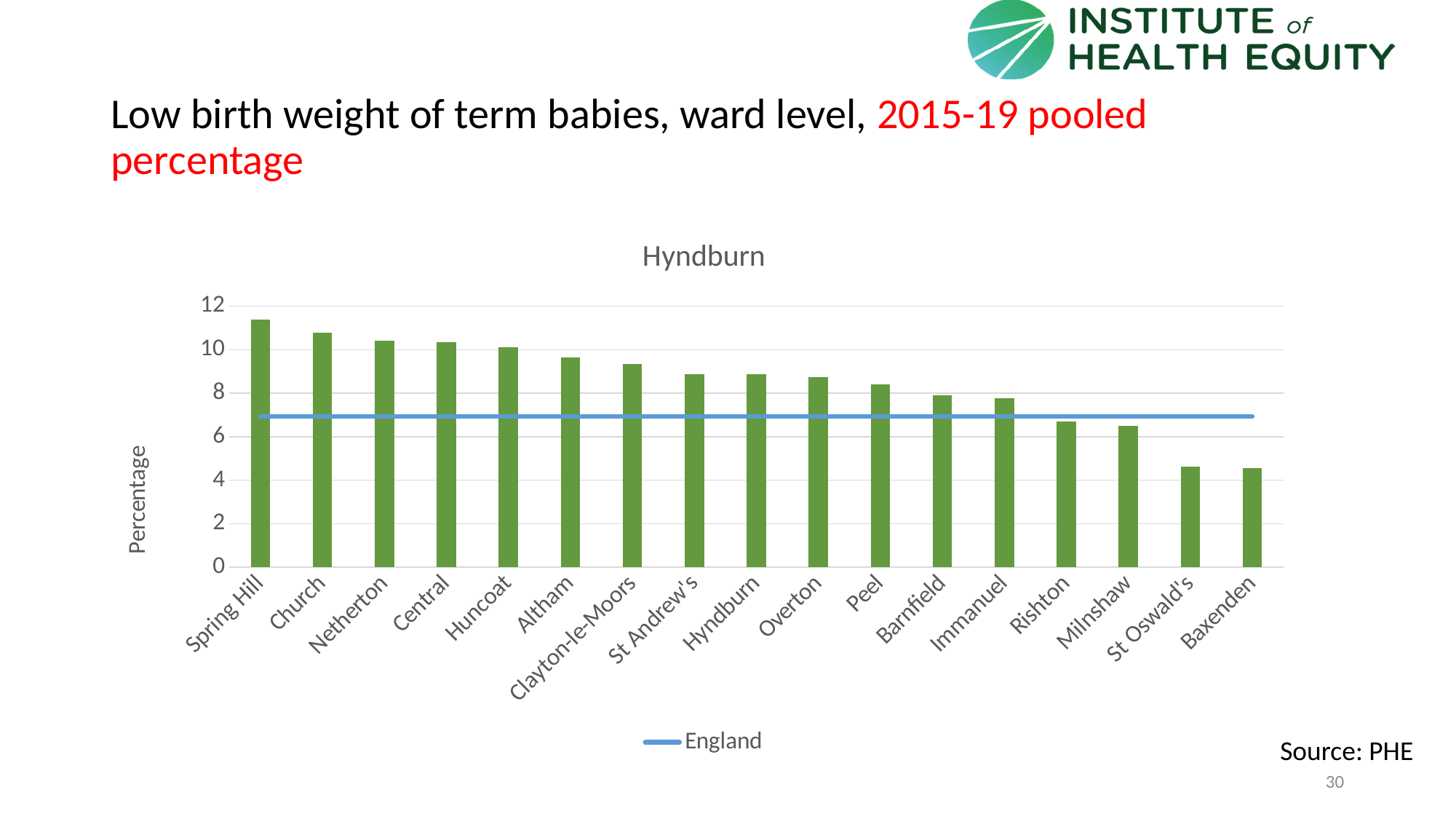
Is the value for Spring Hill greater or less than 10? greater How many series does the legend list? 1 Is the value for Rishton greater or less than 8? less Which is larger, the value for Church or the value for Peel? Church How many wards are plotted on the chart? 17 Which ward has the highest value? Spring Hill Which is larger, the value for Rishton or the value for Netherton? Netherton Do the bar values rise or fall from left to right along the x axis? Fall Is the value for Altham greater or less than 8? greater What kind of chart is shown on the slide? Bar chart What is the title of the chart? Hyndburn